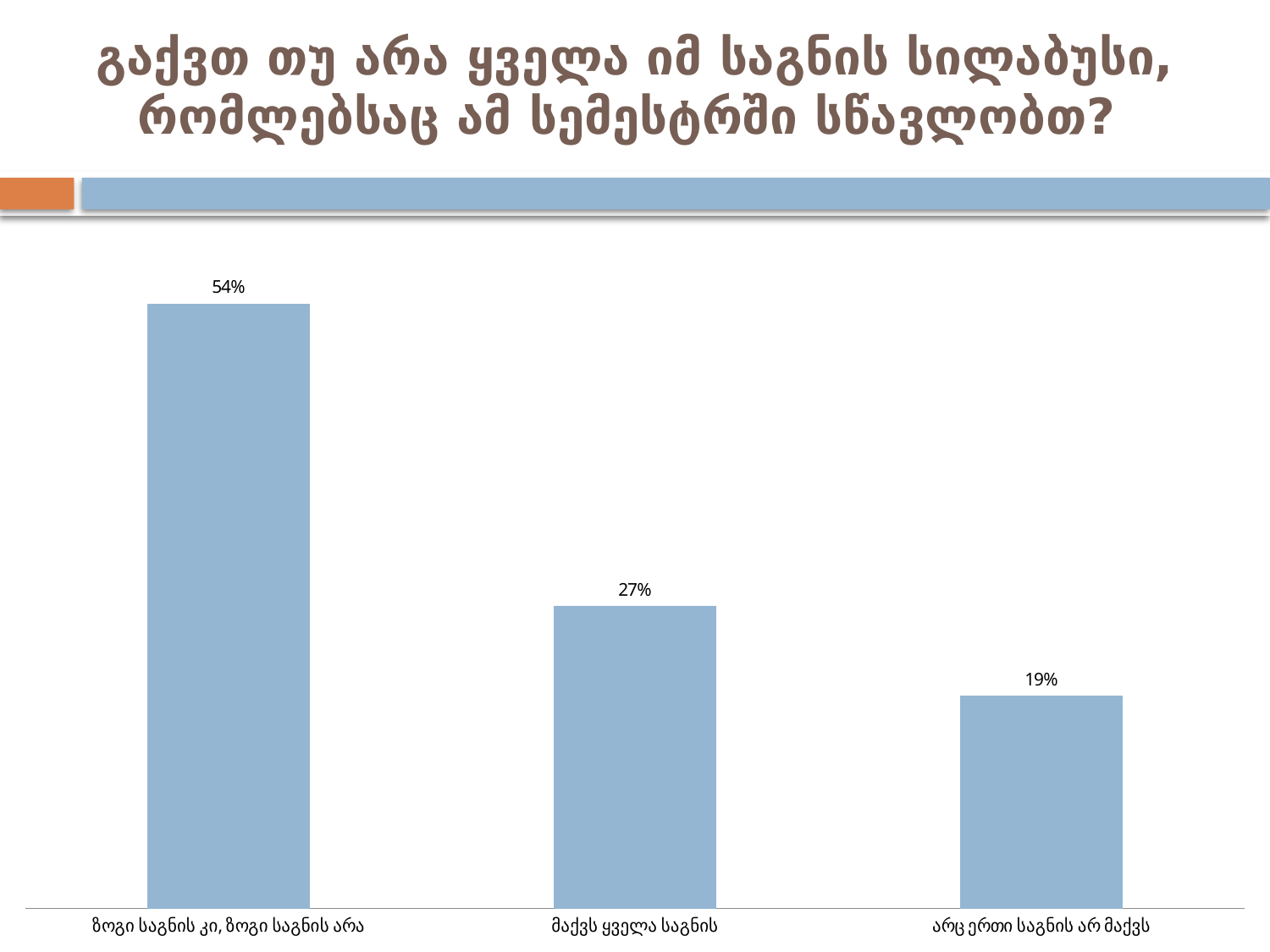
What is the value for "მაქვს ყველა საგნის"? 27% What colour are the bars in the chart? light blue Which category has the lowest value? არც ერთი საგნის არ მაქვს What is the value for "არც ერთი საგნის არ მაქვს"? 19% Which category has the highest value? ზოგი საგნის კი, ზოგი საგნის არა How many categories are shown in the chart? 3 What is the difference between the values for "ზოგი საგნის კი, ზოგი საგნის არა" and "მაქვს ყველა საგნის"? 27% What kind of chart is shown on the slide? bar chart Which is larger, the value for "მაქვს ყველა საგნის" or the value for "არც ერთი საგნის არ მაქვს"? მაქვს ყველა საგნის What is the value for "ზოგი საგნის კი, ზოგი საგნის არა"? 54% Do the values rise or fall from left to right across the categories? fall What is the difference between the values for "მაქვს ყველა საგნის" and "არც ერთი საგნის არ მაქვს"? 8%